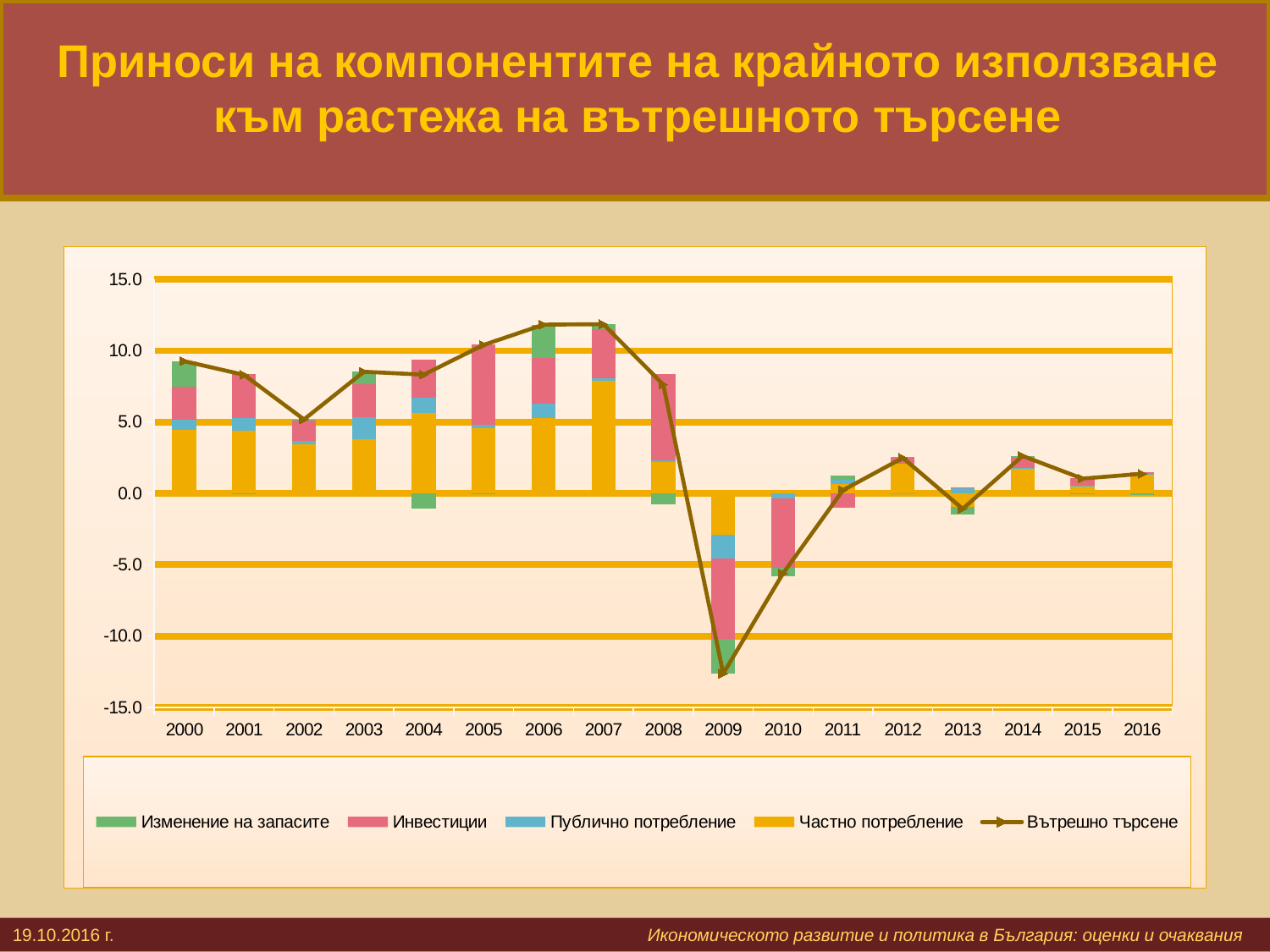
Does the Вътрешно търсене line rise or fall from 2007 to 2009? fall Which legend entry is represented by the line with markers? Вътрешно търсене How many series does the chart legend list? 5 What kind of chart is shown on the slide? Stacked bar chart with a line How many years are shown on the x axis of the chart? 17 Is the Вътрешно търсене value for 2000 greater or less than 10.0? less Is the Вътрешно търсене value for 2007 greater or less than 10.0? greater Which series is shown in yellow in the stacked bars? Частно потребление Is the Вътрешно търсене value for 2013 greater or less than 0.0? less Which year has the higher Вътрешно търсене value, 2001 or 2002? 2001 In which year is the Вътрешно търсене line at its lowest? 2009